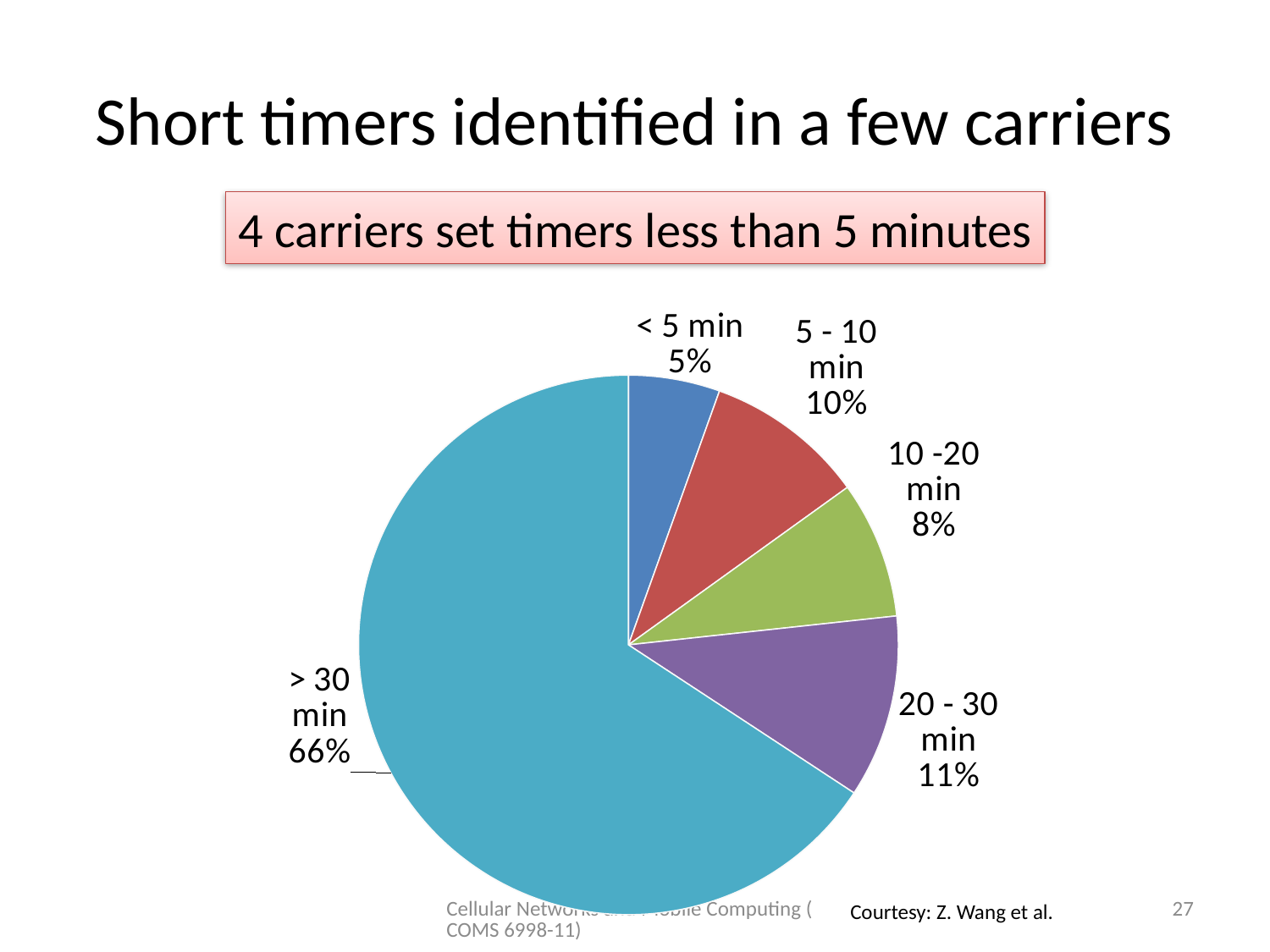
What share of the pie does the "< 5 min" slice represent? 5% Which slice of the pie is the smallest? < 5 min How many slices does the pie chart have? 5 What share of the pie does the "> 30 min" slice represent? 66% What percentage is shown for the "20 - 30 min" slice? 11% What percentage is shown for the "5 - 10 min" slice? 10% What kind of chart is shown on the slide? pie chart What percentage is shown for the "10 -20 min" slice? 8% What colour is the "> 30 min" slice? teal/light blue Which slice of the pie is the largest? > 30 min Which is larger, the "5 - 10 min" slice or the "10 -20 min" slice? 5 - 10 min What is the difference in percentage points between the "> 30 min" slice and the "20 - 30 min" slice? 55